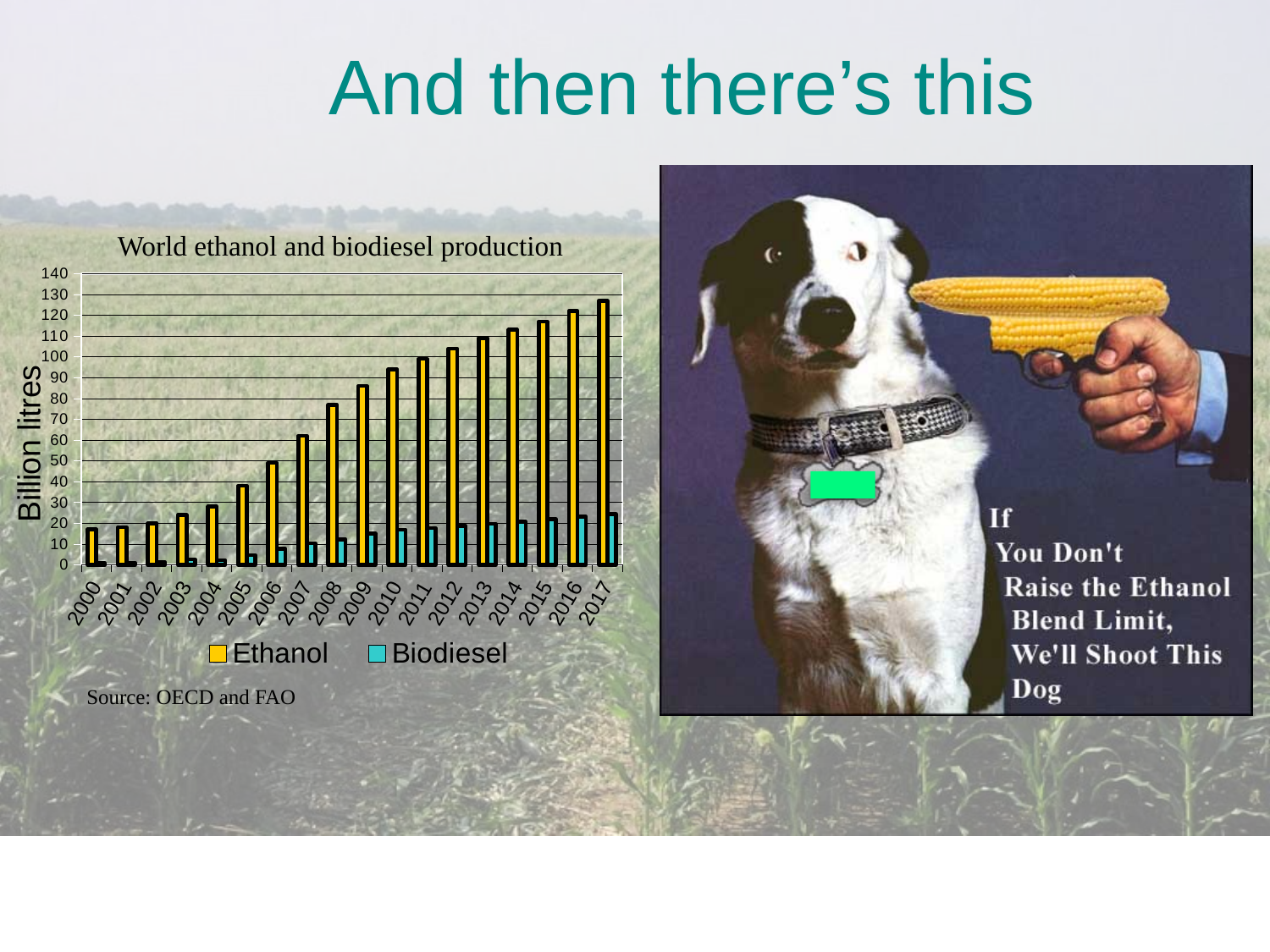
In 2017, which is larger, ethanol production or biodiesel production? Ethanol Is the ethanol value for 2000 greater or less than 20? less In which year is ethanol production highest? 2017 What is the title of the chart? World ethanol and biodiesel production Is the ethanol value for 2009 greater or less than 80? greater Does ethanol production rise or fall from 2000 to 2017? Rise What is the label on the vertical axis of the chart? Billion litres Is the ethanol value for 2017 greater or less than 120? greater How many years are shown on the x axis of the chart? 18 What kind of chart is shown on the slide? Bar chart How many series does the chart's legend list? 2